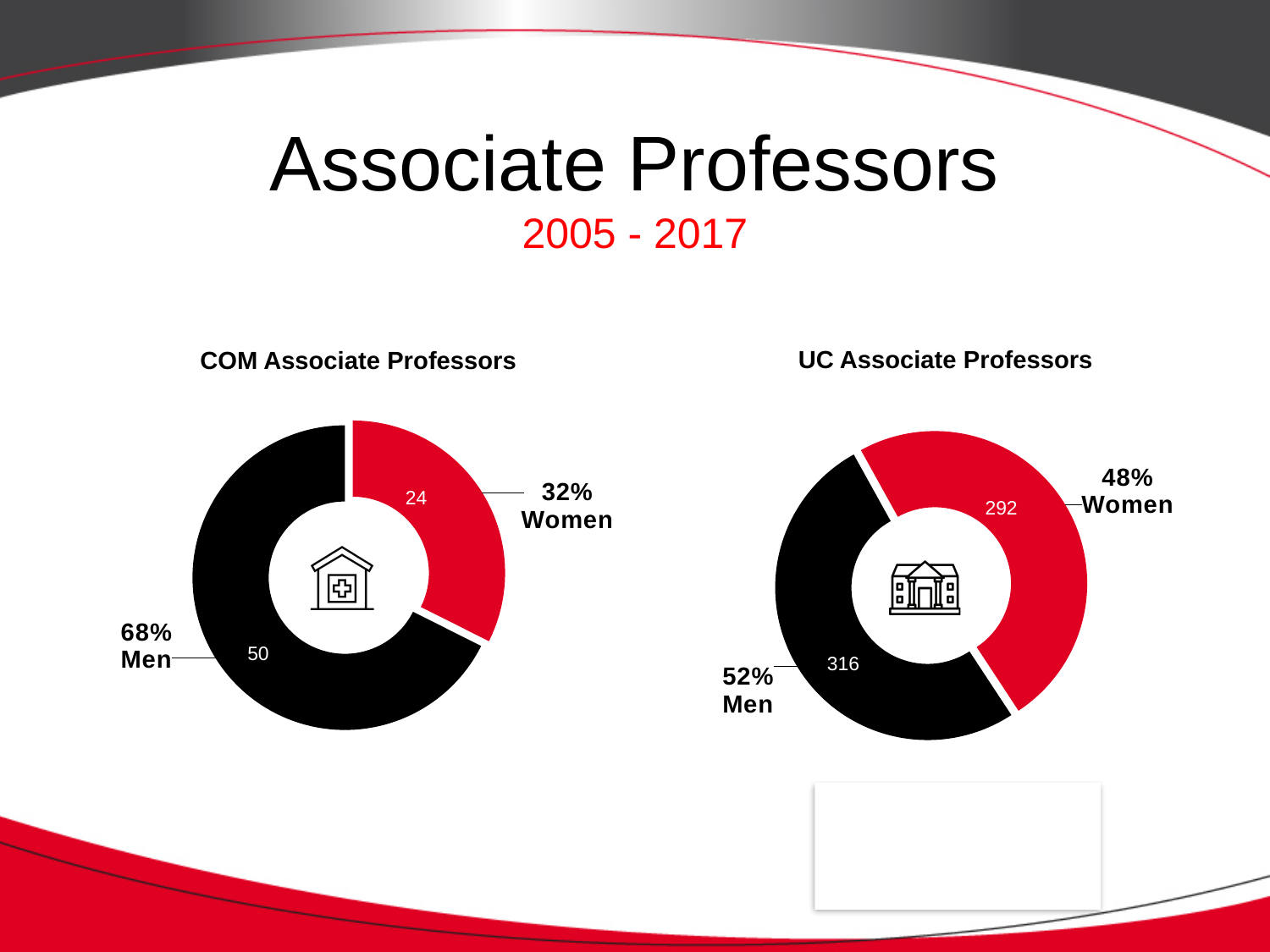
In the UC Associate Professors chart, what is the value for Men? 316 In the UC Associate Professors chart, what share of the pie do Men make up? 52% In the COM Associate Professors chart, which category is the largest? Men What kind of chart is the UC Associate Professors chart? Pie chart (doughnut) In the COM Associate Professors chart, what share of the pie do Women make up? 32% In the COM Associate Professors chart, what colour is the Women slice? Red In the COM Associate Professors chart, what is the difference between the Men and Women values? 26 In the COM Associate Professors chart, what is the value for Women? 24 In the UC Associate Professors chart, which category is the smallest? Women In the UC Associate Professors chart, what is the difference between the Men and Women values? 24 In the UC Associate Professors chart, what is the value for Women? 292 In the COM Associate Professors chart, what is the value for Men? 50